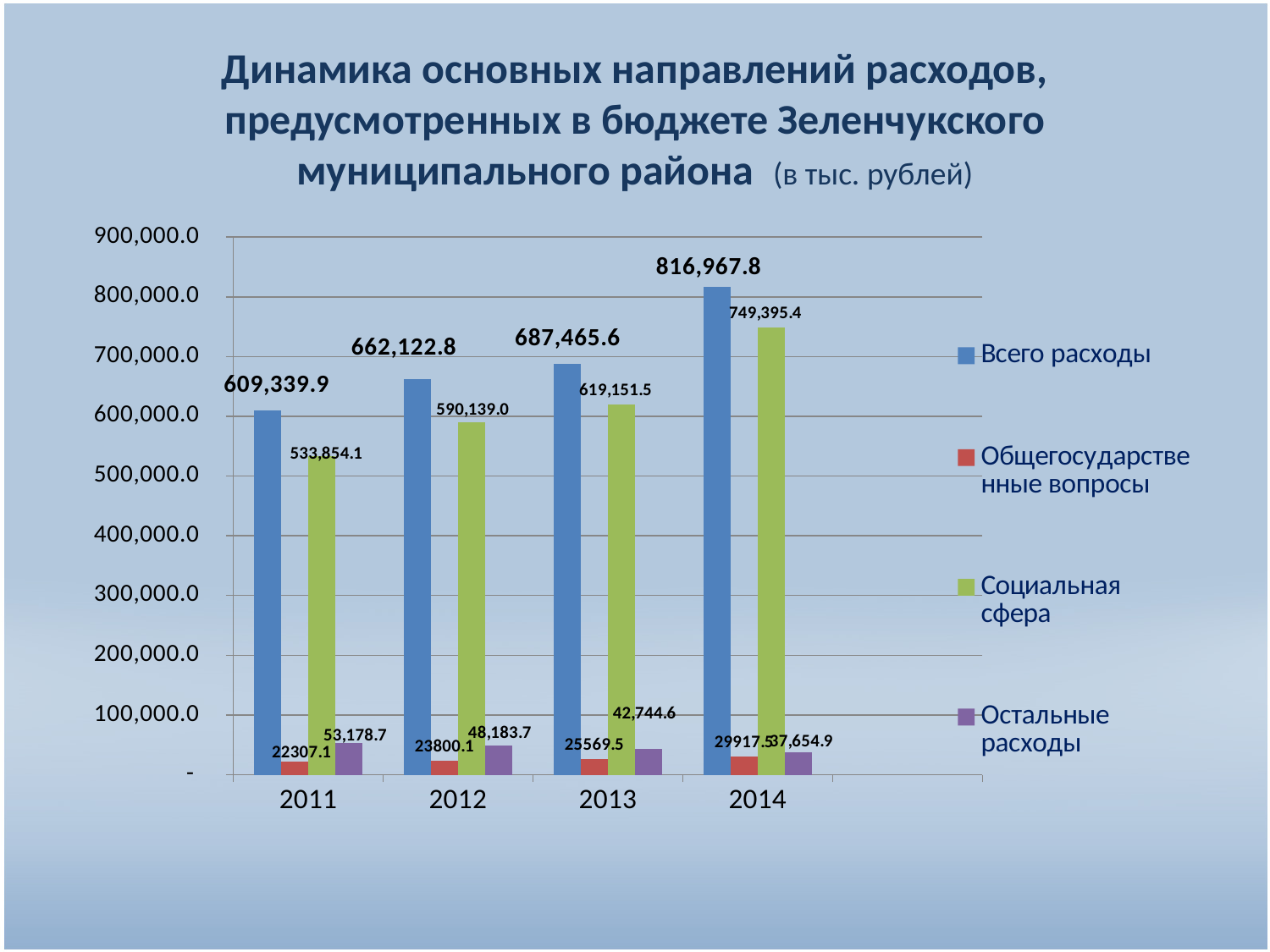
What is the value of Всего расходы for 2014? 816,967.8 What is the value of Социальная сфера for 2012? 590,139.0 What is the difference between Всего расходы in 2014 and in 2011? 207,627.9 What is the value of Остальные расходы for 2011? 53,178.7 Do the values of Всего расходы rise or fall from 2011 to 2014? rise How many series does the legend list? 4 Which is larger in 2013: Социальная сфера or Остальные расходы? Социальная сфера What is the value of Общегосударственные вопросы for 2013? 25569.5 In which year is Остальные расходы the lowest? 2014 In which year is Всего расходы the highest? 2014 Is the value of Социальная сфера for 2014 greater or less than 700,000.0? greater What kind of chart is shown on the slide? bar chart